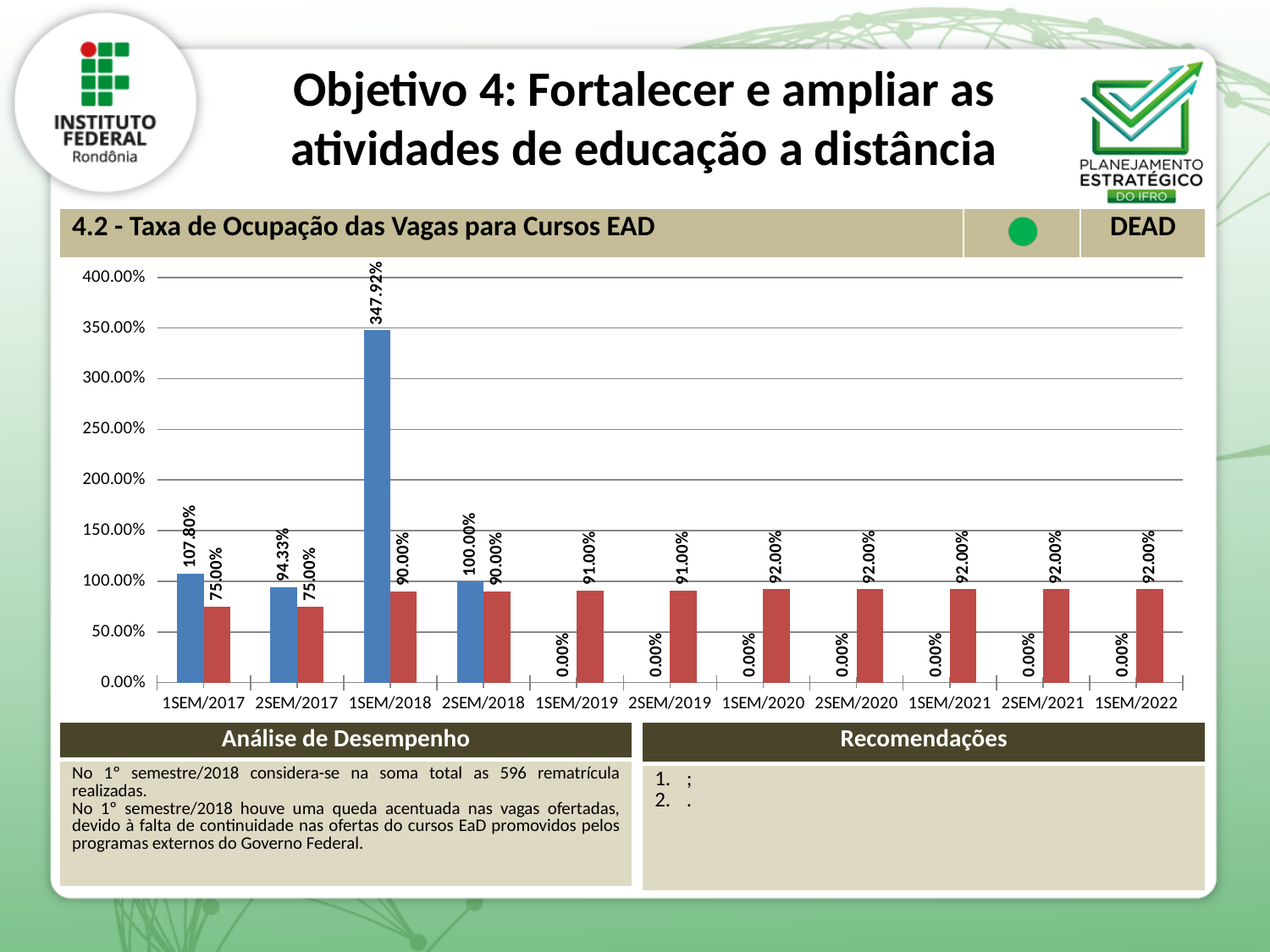
Which category has the highest blue bar? 1SEM/2018 What is the value of the blue bar for 1SEM/2018? 347.92% What is the value of the blue bar for 2SEM/2017? 94.33% Which category has the lowest red bar value? 1SEM/2017 and 2SEM/2017 (75.00%) How many categories are shown on the x axis? 11 What is the title of the indicator shown above the chart? 4.2 - Taxa de Ocupação das Vagas para Cursos EAD What is the value of the red bar for 1SEM/2022? 92.00% Which is larger for 2SEM/2018, the blue bar or the red bar? The blue bar What kind of chart is shown on the slide? Bar chart What is the value of the red bar for 1SEM/2017? 75.00% What is the difference between the blue bar and the red bar for 1SEM/2017? 32.80% Is the blue bar for 1SEM/2018 greater or less than 300.00%? greater